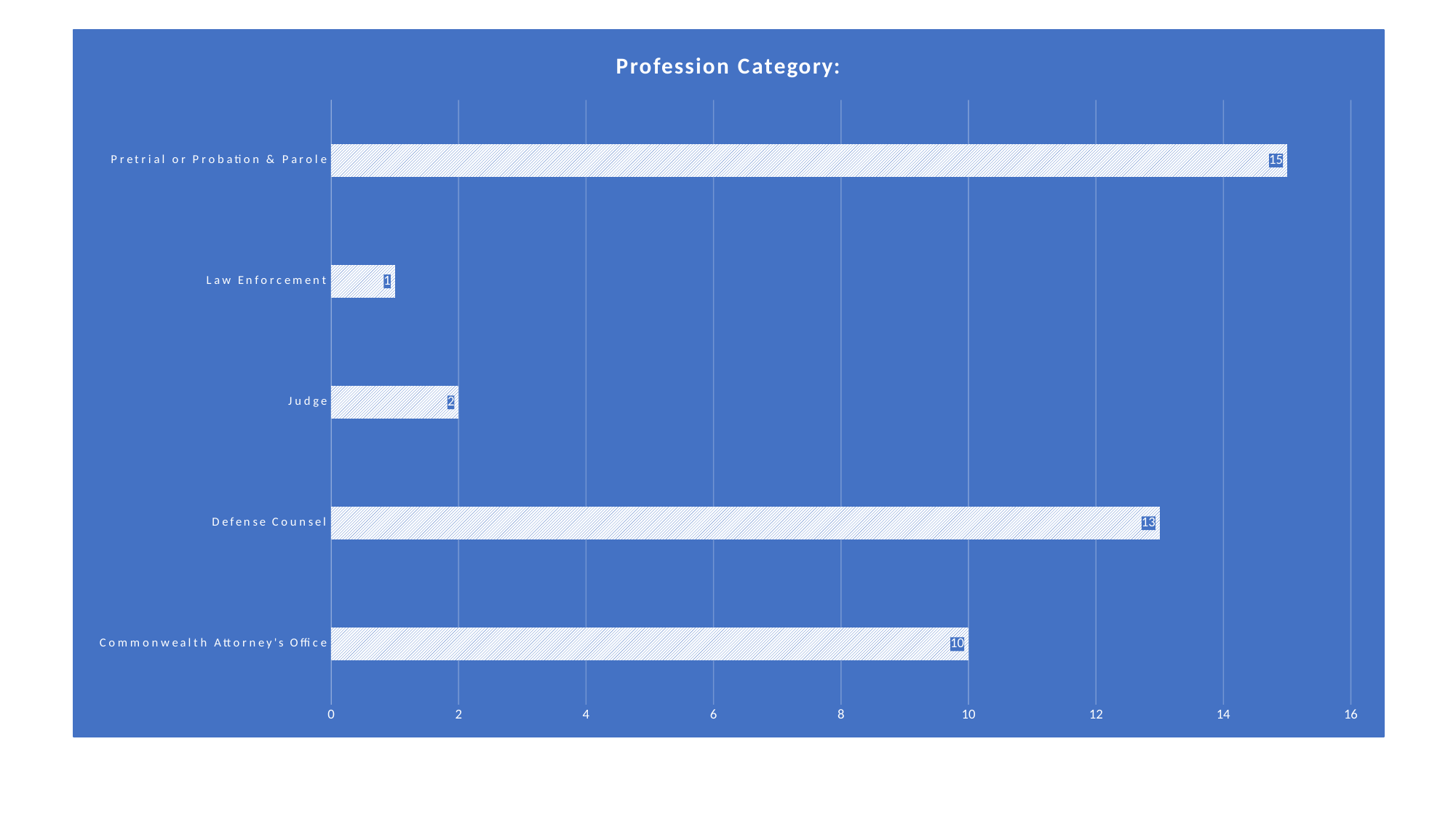
What is the value for Pretrial or Probation & Parole? 15 What kind of chart is shown on the slide? Bar chart Which profession category has the lowest value? Law Enforcement Which profession category has the highest value? Pretrial or Probation & Parole What is the value for Law Enforcement? 1 What is the title of the chart? Profession Category: What is the difference between the values for Defense Counsel and Commonwealth Attorney's Office? 3 What is the value for Commonwealth Attorney's Office? 10 How many profession categories are shown in the chart? 5 What is the difference between the values for Pretrial or Probation & Parole and Defense Counsel? 2 Which is larger, the value for Judge or the value for Law Enforcement? Judge What is the value for Defense Counsel? 13